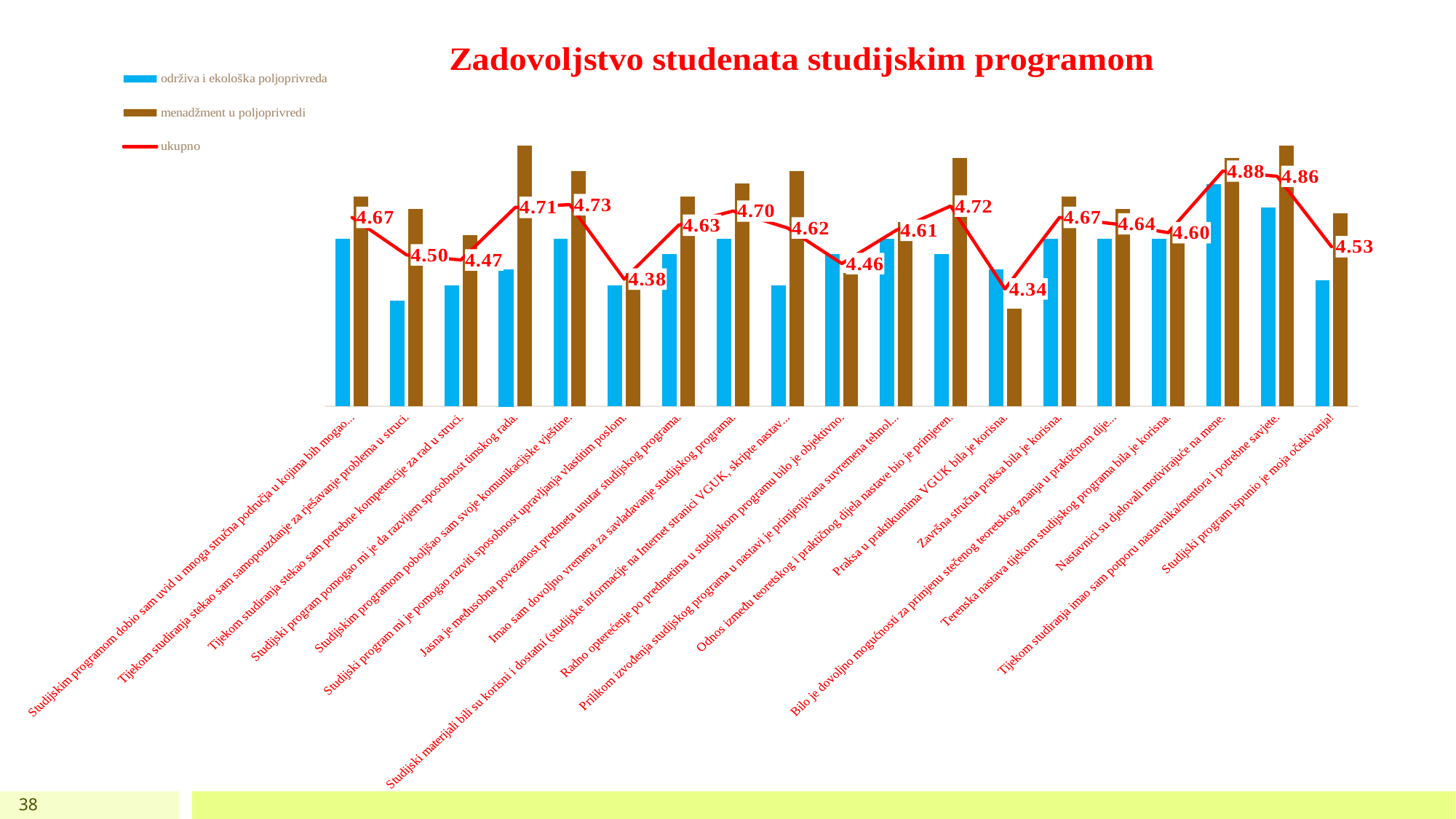
Which has a higher 'ukupno' value: 'Studijskim programom poboljšao sam svoje komunikacijske vještine.' or 'Studijski program pomogao mi je da razvijem sposobnost timskog rada.'? Studijskim programom poboljšao sam svoje komunikacijske vještine. Which statement has the lowest 'ukupno' value? Praksa u praktikumima VGUK bila je korisna. What is the difference between the highest and lowest 'ukupno' values? 0.54 Which statement has the highest 'ukupno' value? Nastavnici su djelovali motivirajuće na mene. How many statements (categories) are shown on the x axis? 19 What is the title of the chart? Zadovoljstvo studenata studijskim programom What is the 'ukupno' value for 'Studijski program ispunio je moja očekivanja!'? 4.53 How many series does the legend list? 3 For 'Studijski program pomogao mi je da razvijem sposobnost timskog rada.', which series has the taller bar: 'održiva i ekološka poljoprivreda' or 'menadžment u poljoprivredi'? menadžment u poljoprivredi What is the 'ukupno' value for 'Nastavnici su djelovali motivirajuće na mene.'? 4.88 What is the 'ukupno' value for 'Studijski program mi je pomogao razviti sposobnost upravljanja vlastitim poslom.'? 4.38 What is the 'ukupno' value for 'Praksa u praktikumima VGUK bila je korisna.'? 4.34